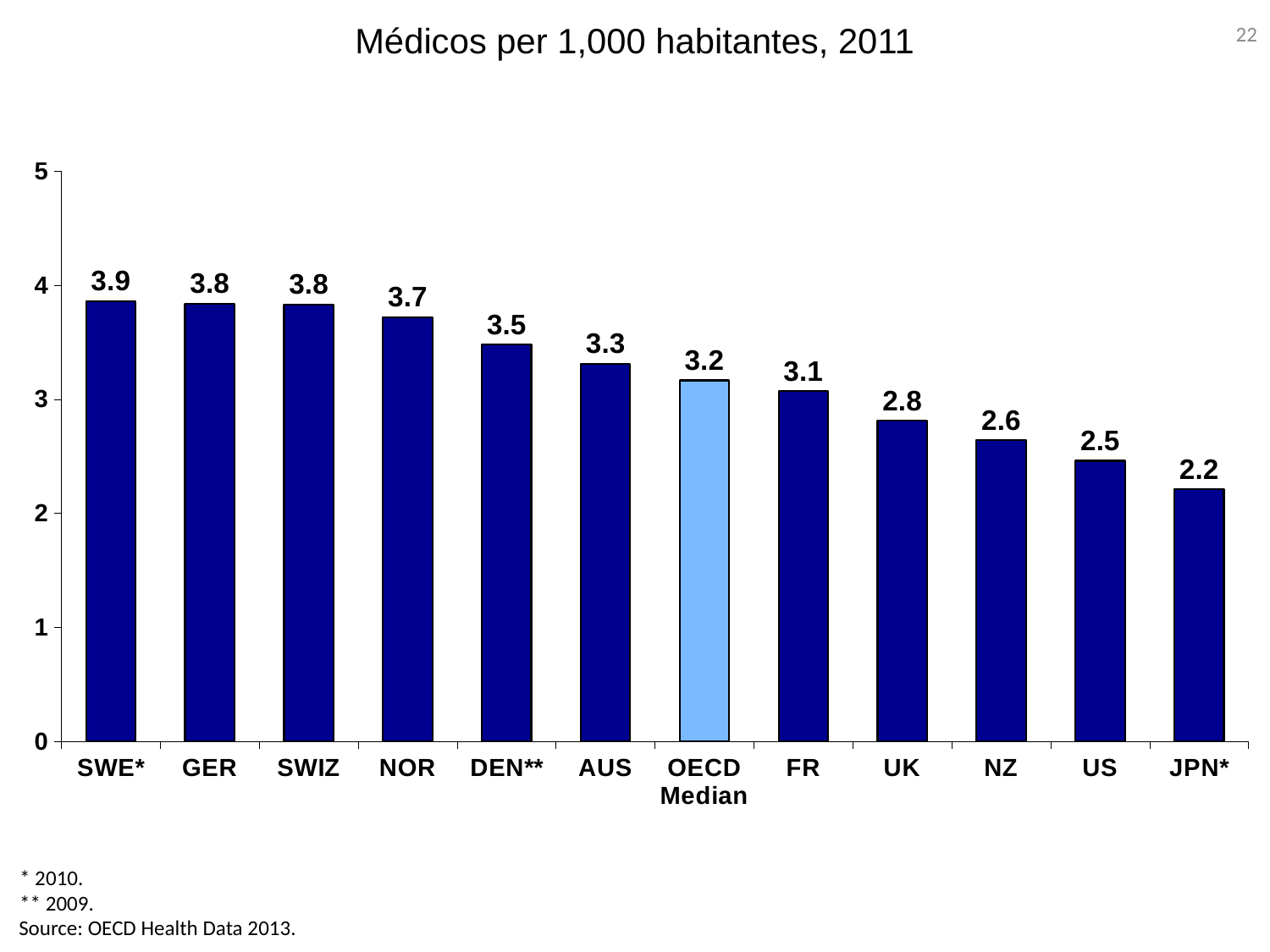
Is the value for NZ greater or less than 3? less What is the value for GER? 3.8 What is the value for US? 2.5 How many categories are shown on the x axis? 12 What kind of chart is this? bar chart Do the values rise or fall from left to right along the x axis? fall Which category has the lowest value? JPN* Which category has the highest value? SWE* What is the difference between the values for SWE* and JPN*? 1.7 Which is larger, the value for AUS or the value for FR? AUS What is the difference between the values for NOR and UK? 0.9 What is the value for the OECD Median? 3.2